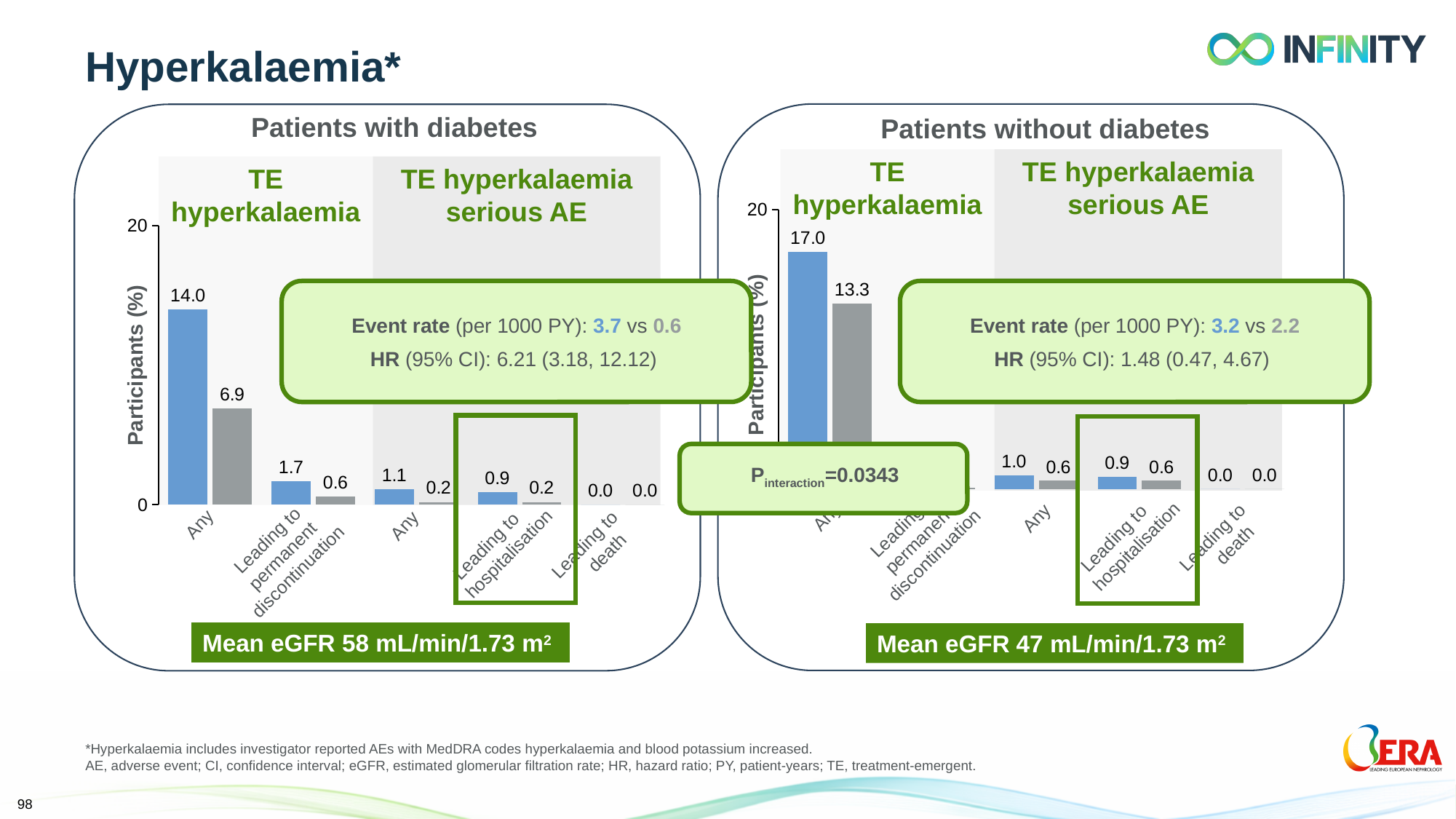
In the 'Patients with diabetes' chart, what is the value of the blue bar for 'Leading to hospitalisation'? 0.9 In the 'Patients without diabetes' chart, what is the value of the grey bar for 'Any' under TE hyperkalaemia? 13.3 In the 'Patients without diabetes' chart, what is the difference between the blue and grey bars for 'Any' under TE hyperkalaemia? 3.7 In the 'Patients with diabetes' chart, what is the value of the grey bar for 'Any' under TE hyperkalaemia? 6.9 In the 'Patients without diabetes' chart, what is the value of the blue bar for 'Any' under TE hyperkalaemia? 17.0 In the 'Patients with diabetes' chart, which category has the highest blue bar? Any (TE hyperkalaemia) In the 'Patients without diabetes' chart, what is the value of the grey bar for 'Leading to hospitalisation'? 0.6 In the 'Patients with diabetes' chart, what is the value of the blue bar for 'Any' under TE hyperkalaemia? 14.0 In the 'Patients with diabetes' chart, what is the difference between the blue and grey bars for 'Any' under TE hyperkalaemia? 7.1 In the 'Patients with diabetes' chart, is the blue bar for 'Any' under TE hyperkalaemia greater or less than the blue bar for 'Any' under TE hyperkalaemia serious AE? greater What is the y-axis label of the 'Patients with diabetes' chart? Participants (%) What type of chart is used in the 'Patients without diabetes' panel? Bar chart